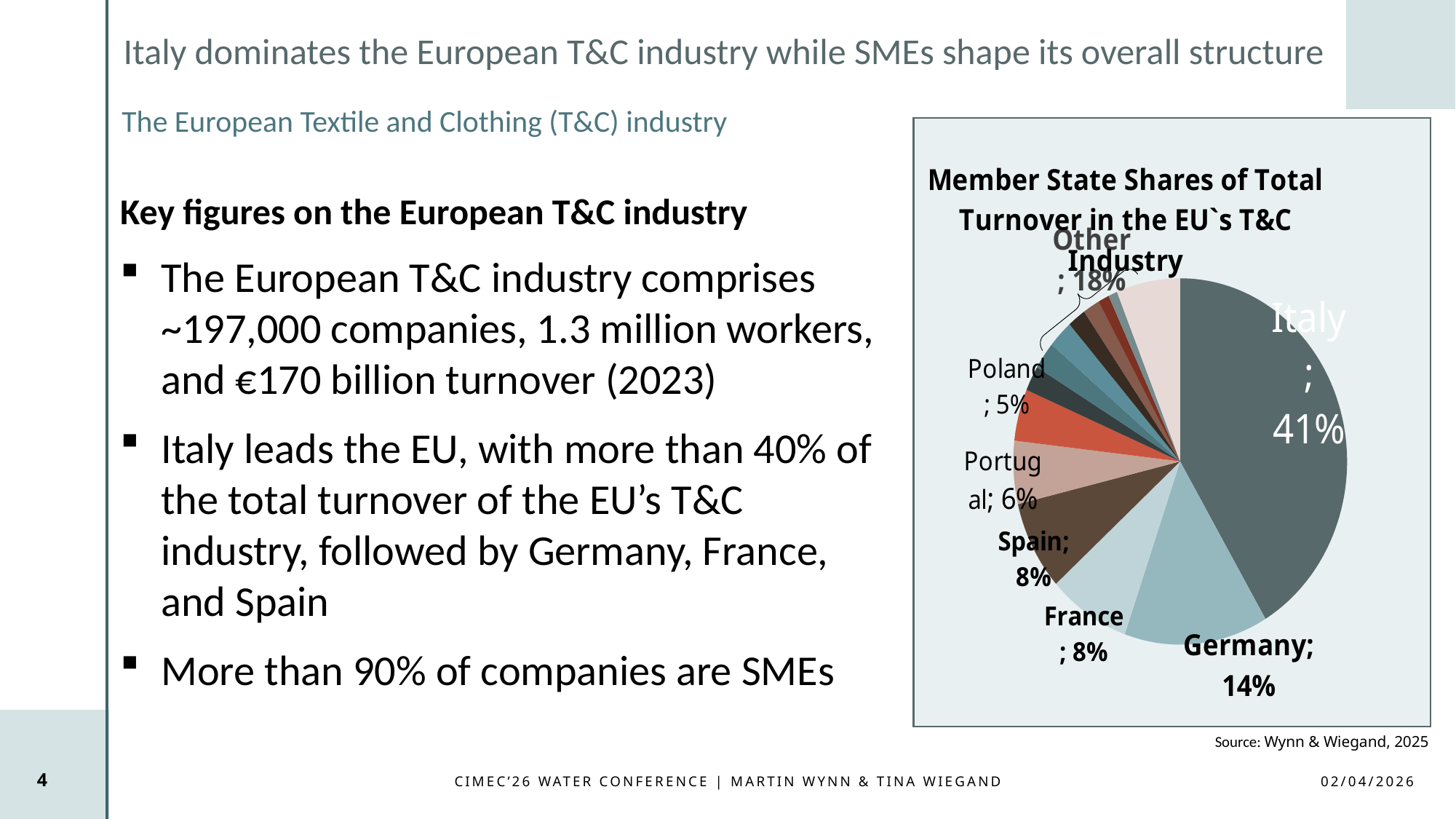
What is the title of the pie chart? Member State Shares of Total Turnover in the EU`s T&C Industry What share is shown for Portugal in the pie chart? 6% Which has the larger share in the pie chart, Germany or Spain? Germany What share is shown for Spain in the pie chart? 8% What share is shown for Poland in the pie chart? 5% Which has the larger share in the pie chart, Portugal or Poland? Portugal What share of total turnover does Germany hold in the pie chart? 14% By how many percentage points does Italy's share exceed Germany's share in the pie chart? 27 percentage points What share of total turnover in the EU's T&C industry does Italy hold according to the pie chart? 41% What share is shown for the 'Other' slice in the pie chart? 18% What kind of chart is shown on the slide? Pie chart Which member state has the largest share of total turnover in the pie chart? Italy